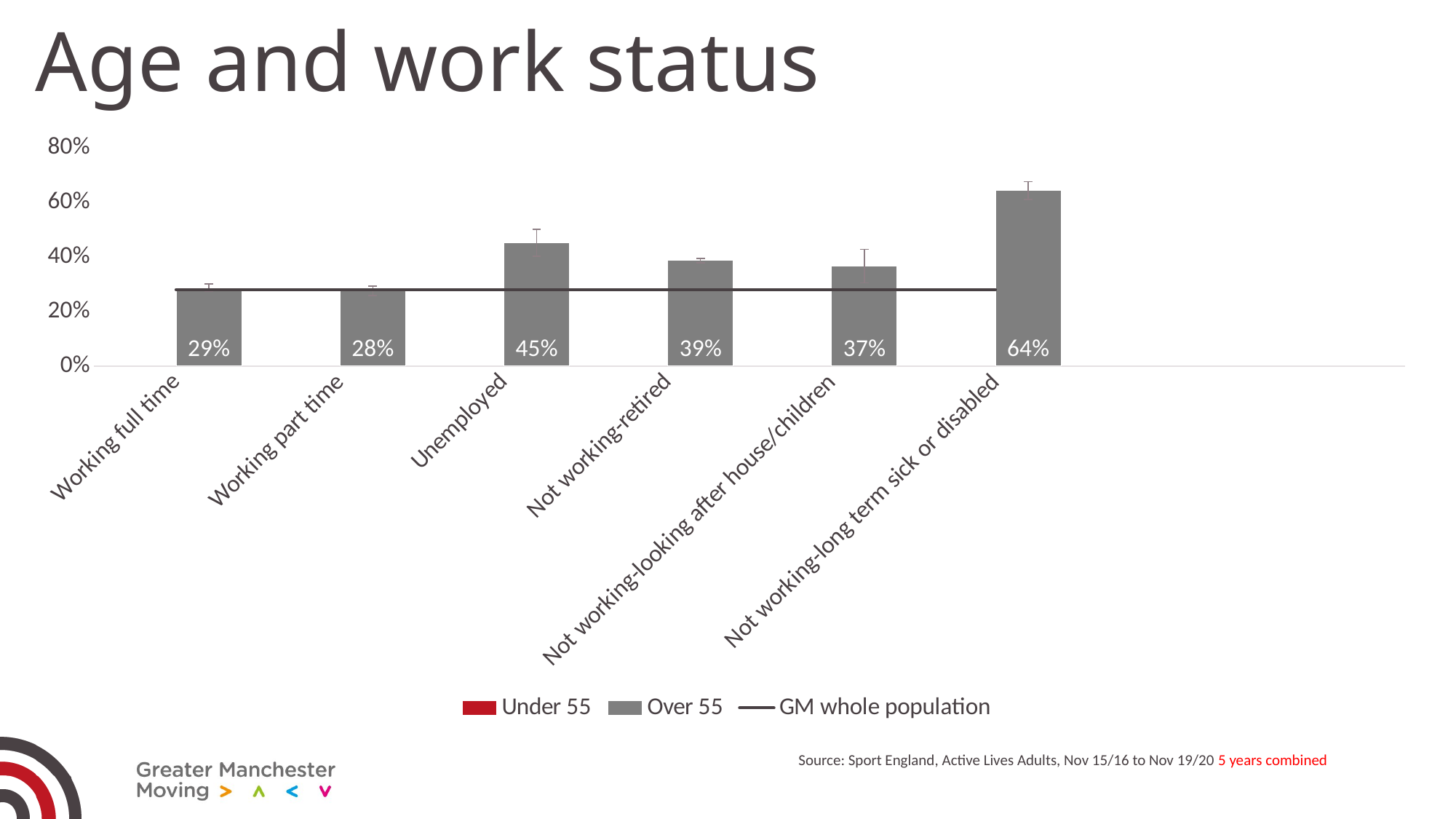
What is the title of the slide? Age and work status Which category has the lowest value? Working part time Which category has the highest value? Not working-long term sick or disabled How many categories are shown on the x axis? 6 Is the value for Not working-long term sick or disabled greater or less than 60%? greater What is the difference between the values for Unemployed and Not working-retired? 6% What is the value for Unemployed? 45% What is the value for Not working-long term sick or disabled? 64% How many entries does the legend list? 3 What kind of chart is shown on the slide? bar and line chart Which is larger, the value for Not working-retired or the value for Not working-looking after house/children? Not working-retired What is the value for Working part time? 28%